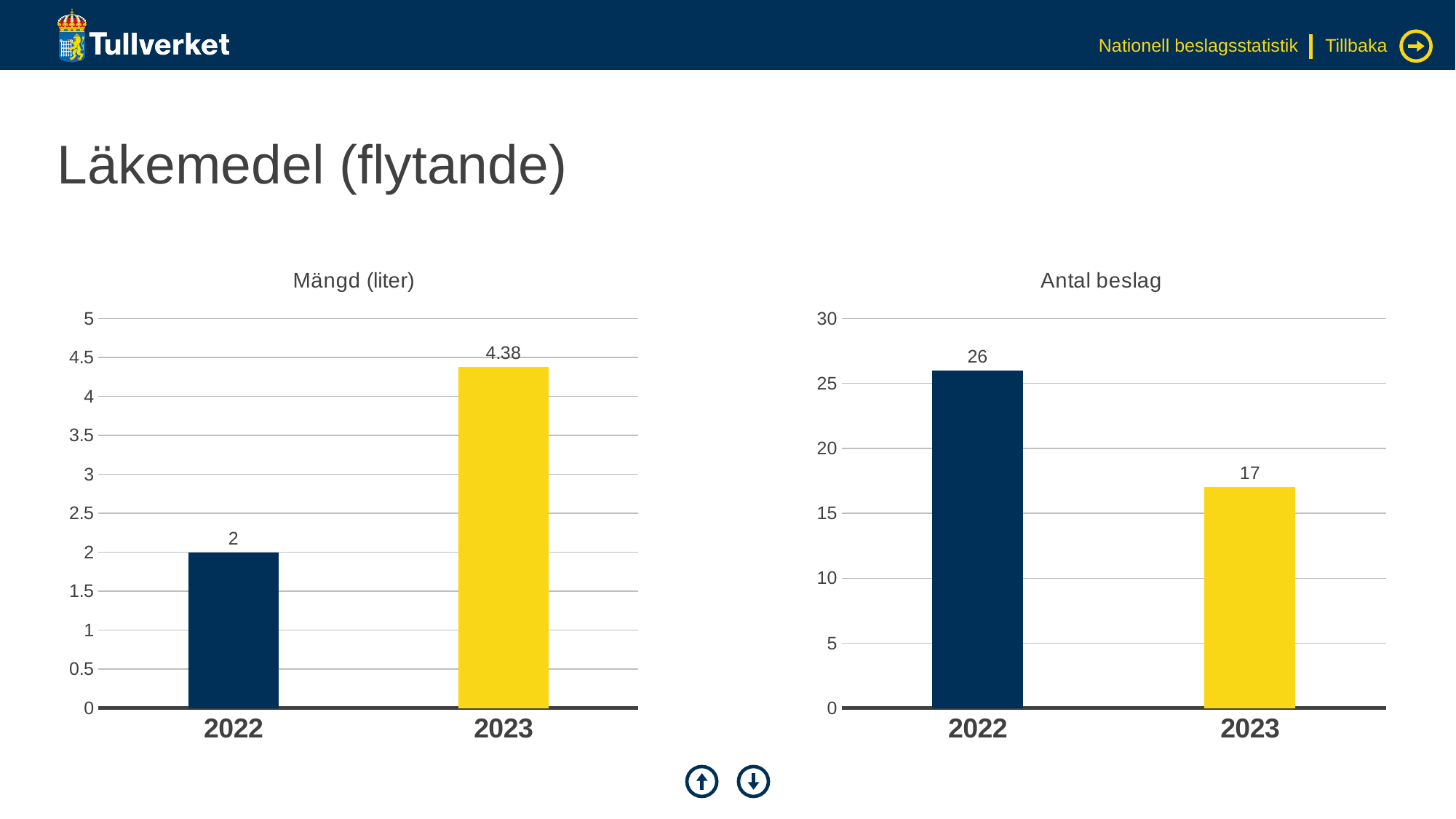
In the 'Mängd (liter)' chart, what is the value for 2023? 4.38 In the 'Mängd (liter)' chart, what is the value for 2022? 2 In the 'Antal beslag' chart, what is the value for 2023? 17 What kind of chart is the 'Mängd (liter)' chart? bar chart In the 'Antal beslag' chart, what is the value for 2022? 26 In the 'Mängd (liter)' chart, is the value for 2023 greater or less than 4? greater In the 'Mängd (liter)' chart, what is the difference between the values for 2023 and 2022? 2.38 How many categories are shown on the x axis of the 'Antal beslag' chart? 2 In the 'Antal beslag' chart, what is the difference between the values for 2022 and 2023? 9 In the 'Mängd (liter)' chart, which year has the lowest value? 2022 In the 'Antal beslag' chart, which year has the highest value? 2022 In the 'Antal beslag' chart, do the values rise or fall from 2022 to 2023? fall